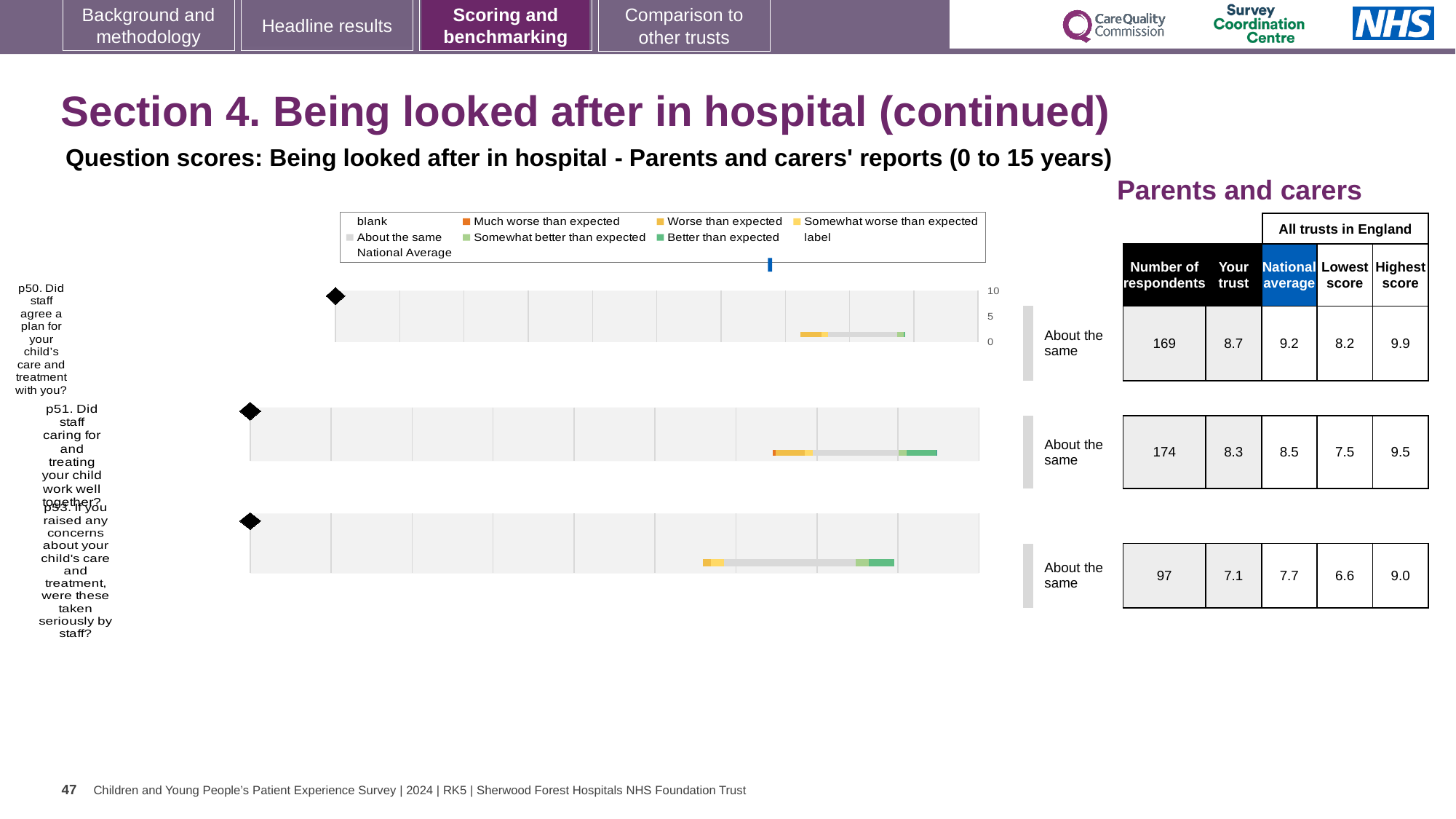
How many respondents answered p53 (If you raised any concerns about your child's care and treatment, were these taken seriously by staff?)? 97 Which question has the highest 'Your trust' score? p50 What is the difference between the highest score and the lowest score for p53? 2.4 What is the national average score for p51 (Did staff caring for and treating your child work well together?)? 8.5 What is the 'Your trust' score for p50 (Did staff agree a plan for your child's care and treatment with you?)? 8.7 What benchmark category is shown for p53? About the same What kind of chart is used to show the question scores on this slide? bar chart How many questions are plotted in the benchmarking charts on this slide? 3 Which question has the lowest 'Your trust' score? p53 What is the maximum value shown on the score axis of the benchmarking charts? 10 For p51, which is larger: the 'Your trust' score or the national average? National average What is the difference between the national average and the 'Your trust' score for p50? 0.5